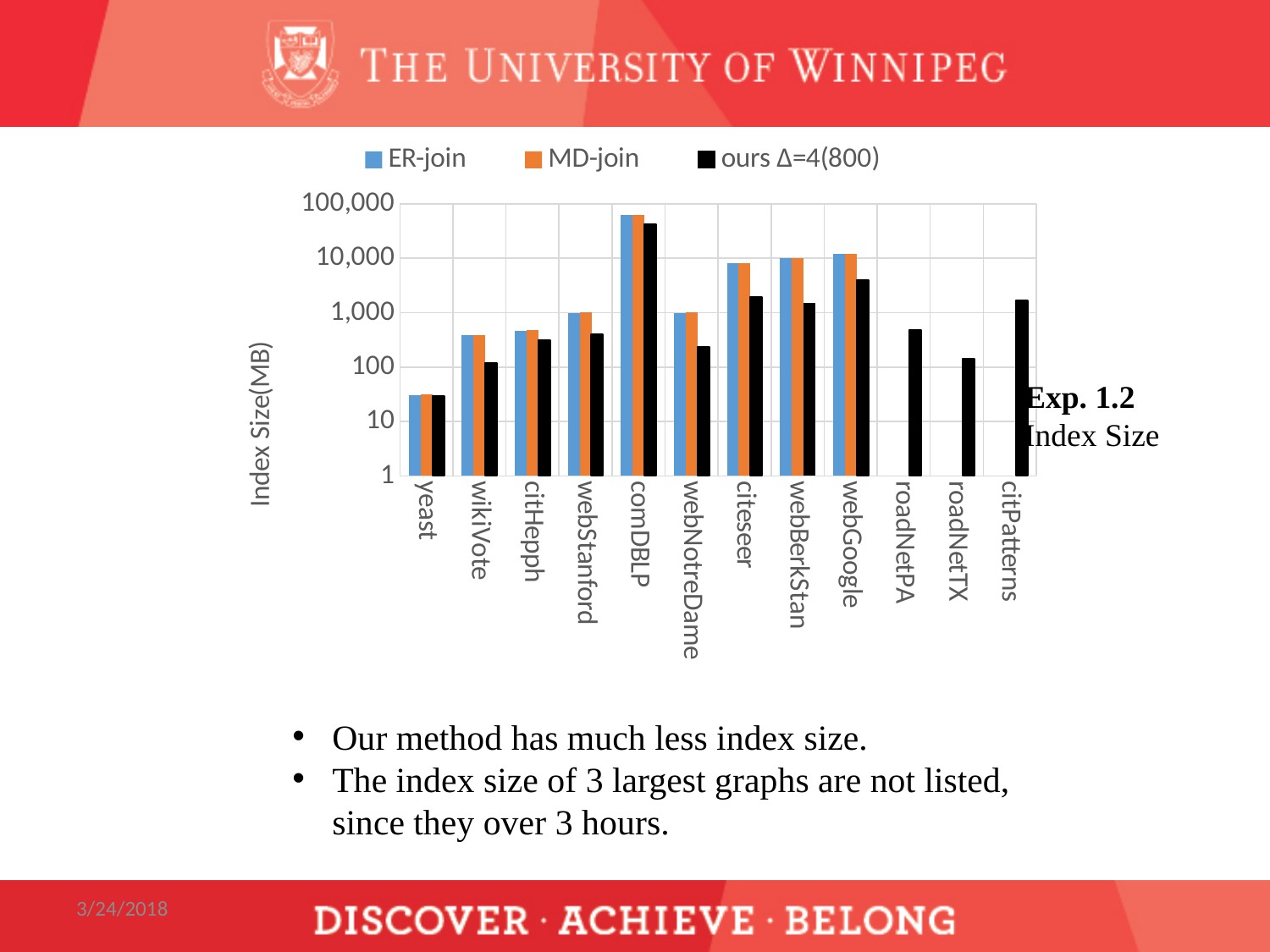
Is the ER-join value for comDBLP greater or less than 10,000? greater What is the label of the y axis? Index Size(MB) How many categories (graphs) are shown along the x axis? 12 Which category has the highest ER-join index size? comDBLP Is the ER-join value for yeast greater or less than 100? less Is the 'ours Δ=4(800)' value for webGoogle greater or less than 10,000? less Which category has the lowest index size for the 'ours Δ=4(800)' series? yeast What kind of chart is shown on the slide? bar chart How many series does the legend list? 3 For webGoogle, which is larger: the ER-join value or the 'ours Δ=4(800)' value? ER-join